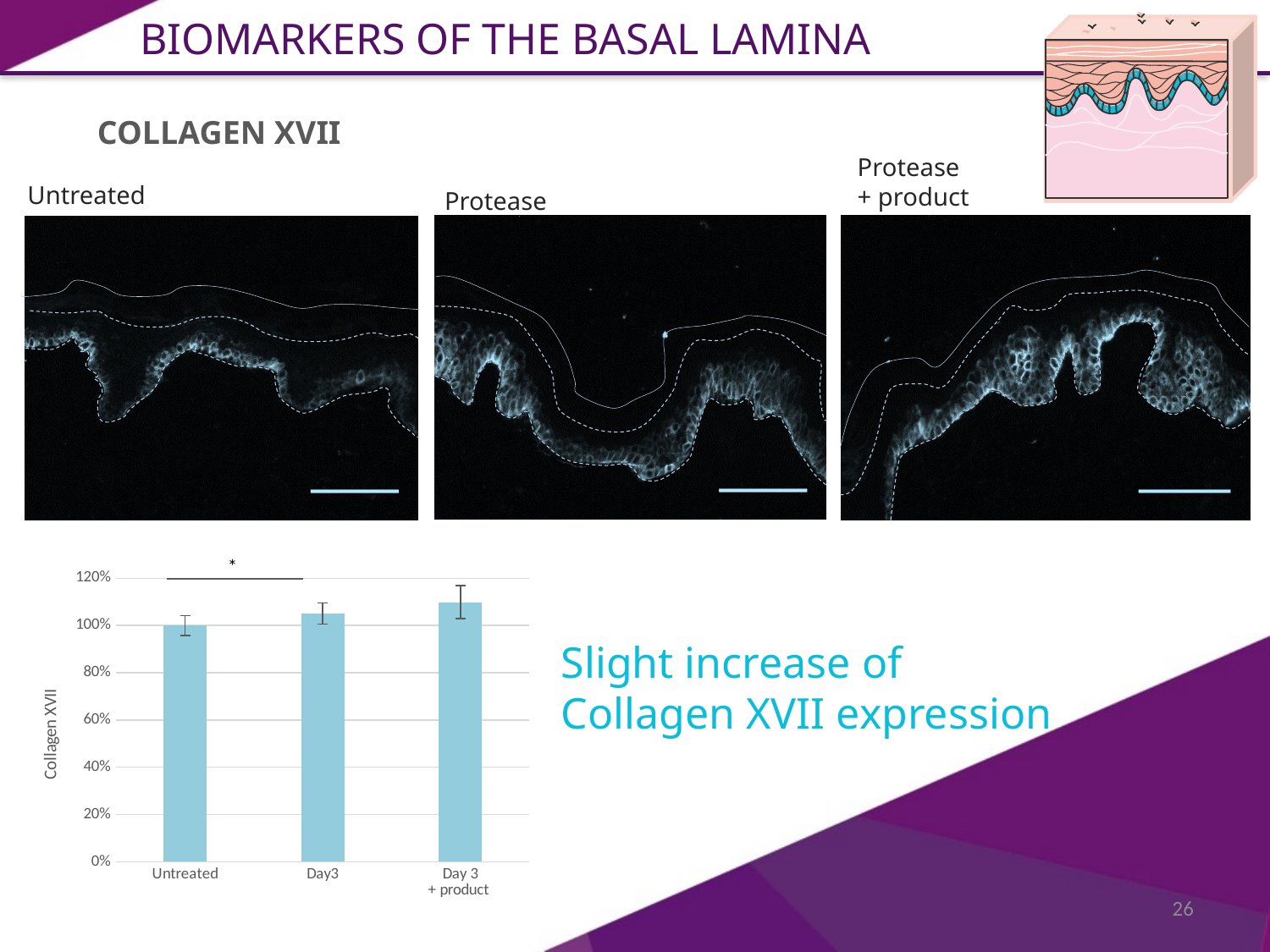
Is the value for Day 3 + product greater or less than 100%? greater What is the value of the Untreated bar in the Collagen XVII chart? 100% Is the value for Day3 greater or less than 100%? greater What is the highest value shown on the y axis of the bar chart? 120% Which category has the highest bar in the Collagen XVII chart? Day 3 + product Which is larger, the Untreated bar or the Day 3 + product bar? Day 3 + product How many categories are plotted on the x axis of the bar chart? 3 Is the value for Day 3 + product greater or less than 120%? less What is the label on the y axis of the bar chart? Collagen XVII What kind of chart is shown at the bottom left of the slide? bar chart Which category has the lowest bar in the Collagen XVII chart? Untreated Do the bar values rise or fall from left to right across the x axis? rise